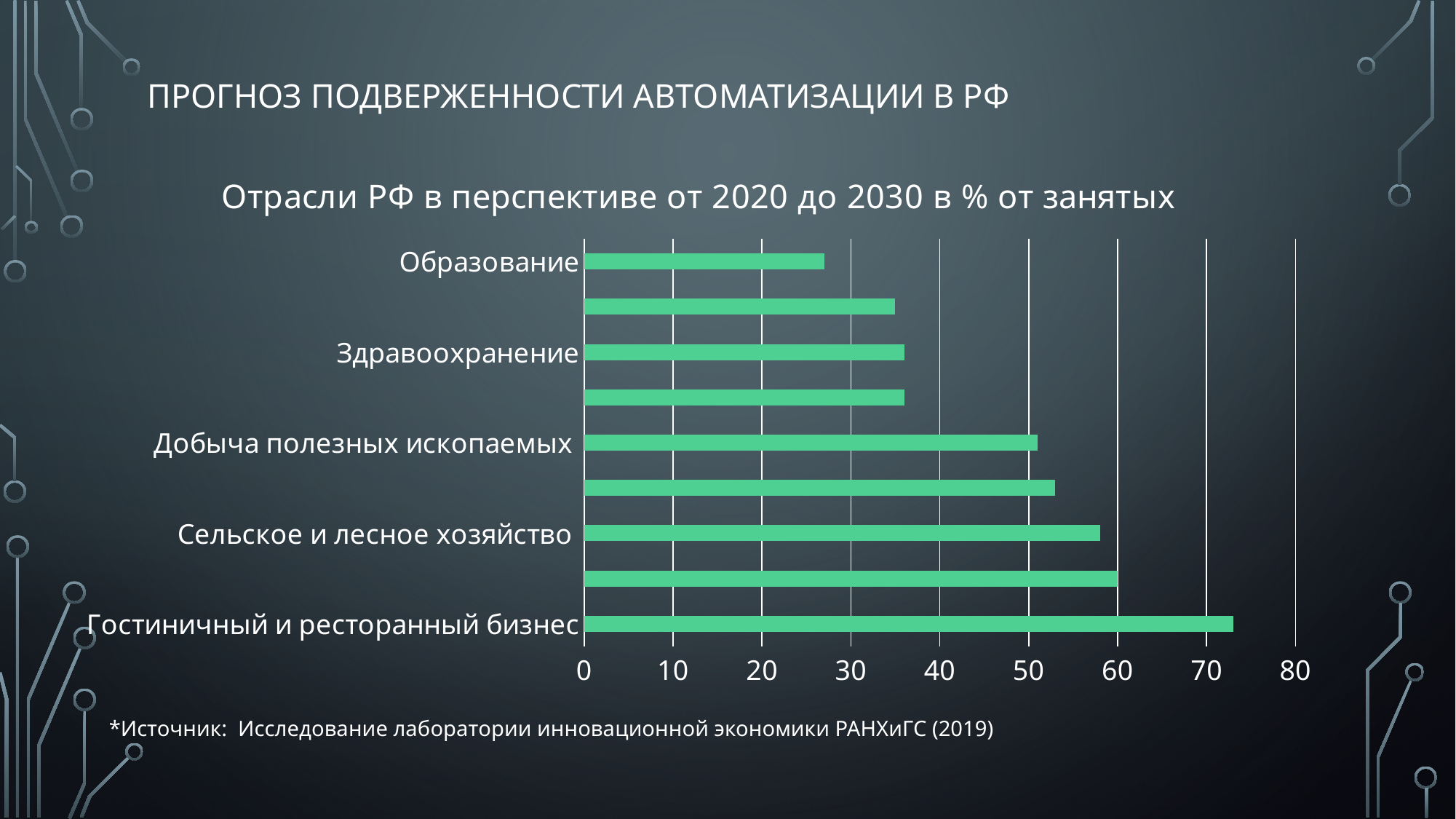
Is the value for Гостиничный и ресторанный бизнес greater or less than 70? greater Is the value for Образование greater or less than 30? less Is the value for Добыча полезных ископаемых greater or less than 40? greater Which labelled category has the lowest value? Образование How many bars are plotted in the chart? 9 What kind of chart is shown on the slide? bar chart What is the title of the chart? Отрасли РФ в перспективе от 2020 до 2030 в % от занятых Which is larger, the value for Сельское и лесное хозяйство or the value for Здравоохранение? Сельское и лесное хозяйство Which labelled category has the highest value? Гостиничный и ресторанный бизнес Which is larger, the value for Образование or the value for Добыча полезных ископаемых? Добыча полезных ископаемых